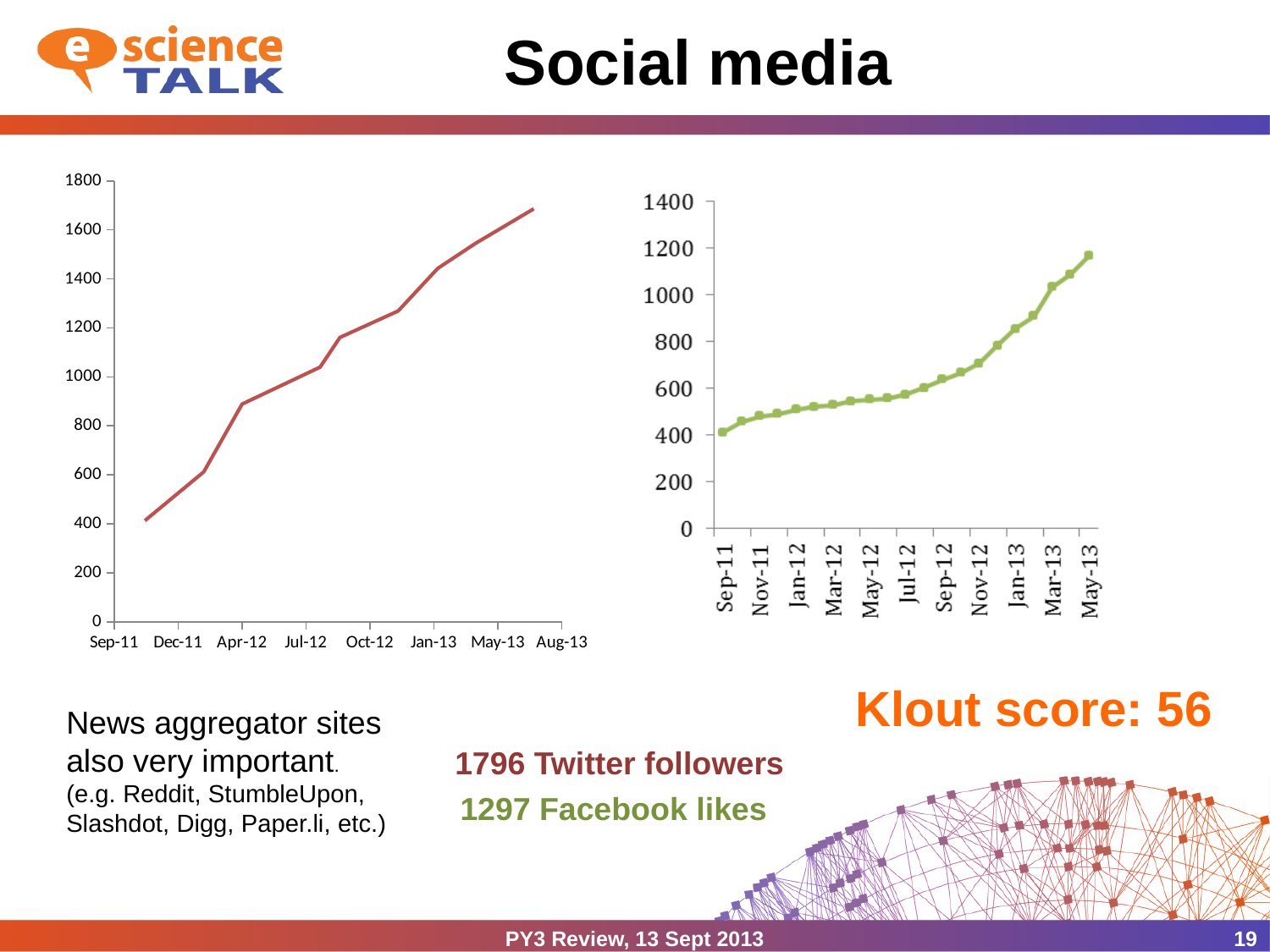
In the chart on the right, is the value at Mar-12 greater or less than 600? less In the chart on the right, which x-axis label has the highest value? May-13 In the chart on the left, is the value at Apr-12 greater or less than 1000? less In the chart on the left, is the value at Sep-11 greater or less than 600? less In the chart on the left, do the values rise or fall from Sep-11 to Aug-13? rise What kind of chart is the chart on the right of the slide? line chart In the chart on the left, which x-axis label has the lowest value? Sep-11 What kind of chart is the chart on the left of the slide? line chart How many x-axis labels are shown on the chart on the right? 11 In the chart on the right, do the values rise or fall from Sep-11 to May-13? rise